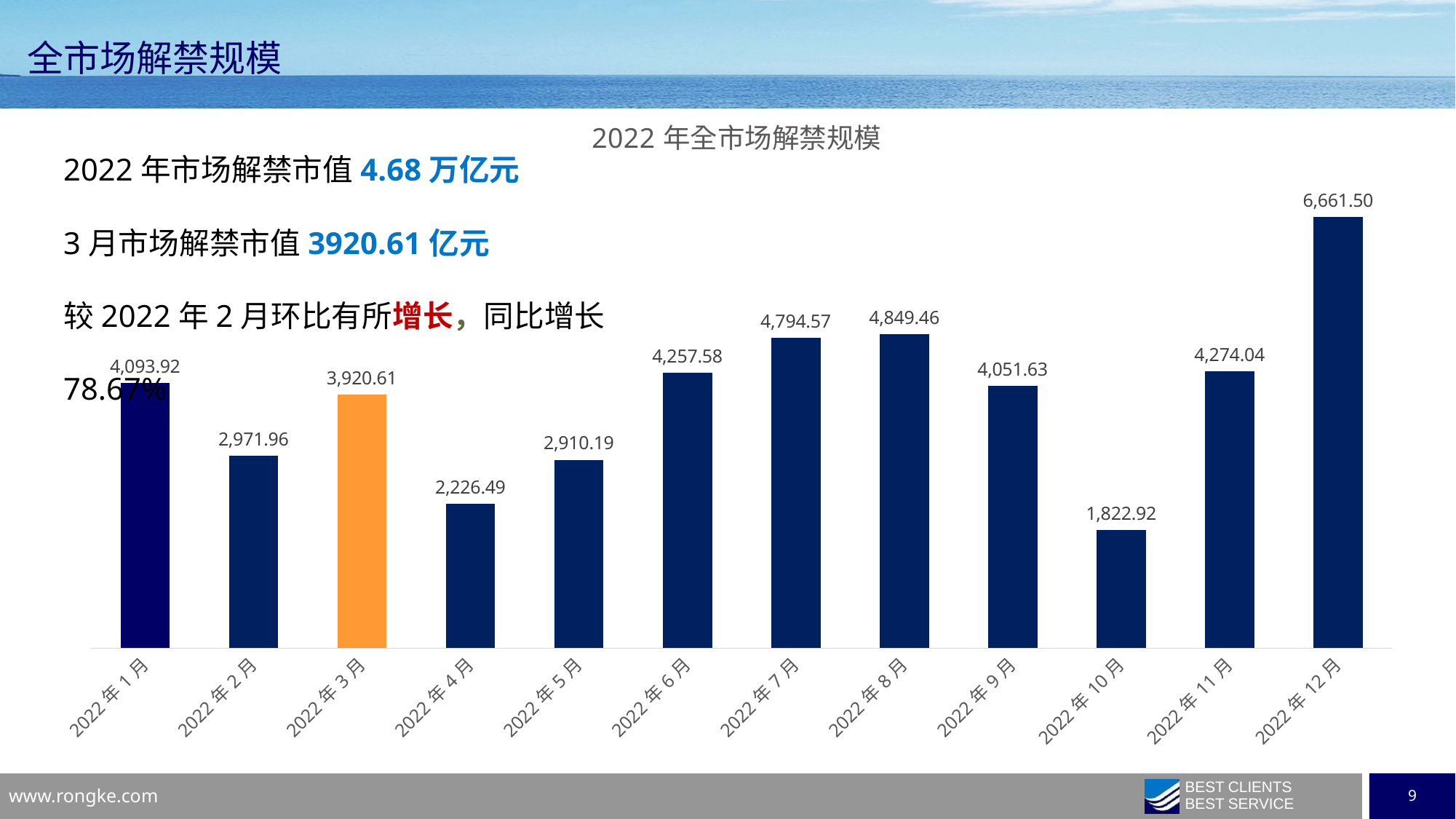
Which is larger, the value for 2022 年 6 月 or the value for 2022 年 5 月? 2022 年 6 月 What kind of chart is shown on the slide? Bar chart Which is larger, the value for 2022 年 1 月 or the value for 2022 年 4 月? 2022 年 1 月 What is the value for 2022 年 3 月 in the chart? 3,920.61 What is the difference between the values for 2022 年 12 月 and 2022 年 10 月? 4,838.58 What is the value for 2022 年 10 月 in the chart? 1,822.92 Which month has the highest value in the chart? 2022 年 12 月 What is the difference between the values for 2022 年 3 月 and 2022 年 2 月? 948.65 How many months are shown on the x axis of the chart? 12 What is the title of the chart? 2022 年全市场解禁规模 Which month has the lowest value in the chart? 2022 年 10 月 What is the value for 2022 年 7 月 in the chart? 4,794.57